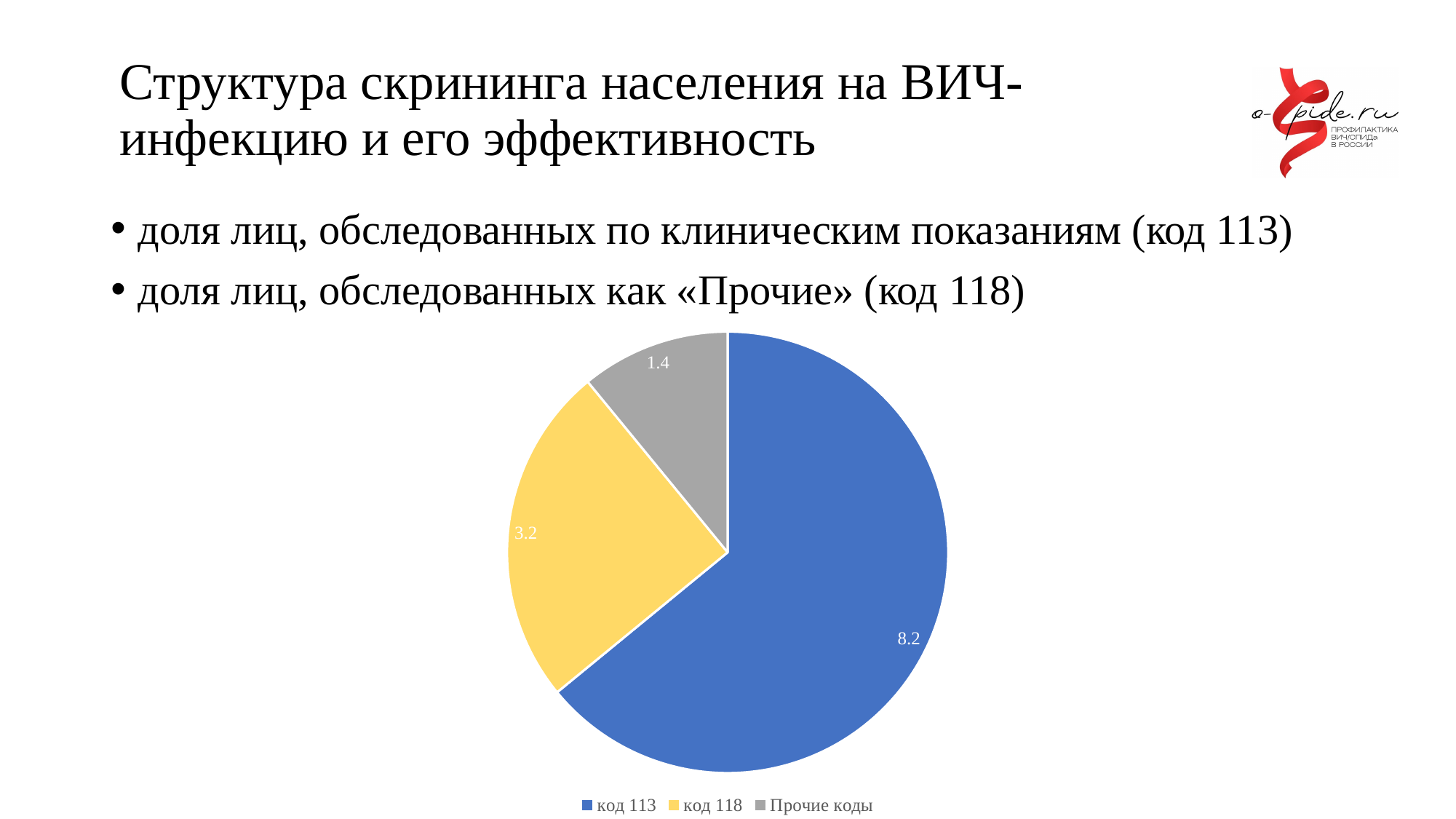
How many slices does the pie chart have? 3 What is the difference between the values for код 118 and Прочие коды? 1.8 Which slice of the pie chart is the smallest? Прочие коды What is the difference between the values for код 113 and код 118? 5.0 What is the value for Прочие коды in the pie chart? 1.4 What kind of chart is shown on the slide? pie chart What is the value for код 118 in the pie chart? 3.2 What colour is the slice for код 118 in the pie chart? yellow How many entries does the legend of the pie chart list? 3 Which slice of the pie chart is the largest? код 113 What is the value for код 113 in the pie chart? 8.2 Which is larger, the value for код 118 or the value for Прочие коды? код 118